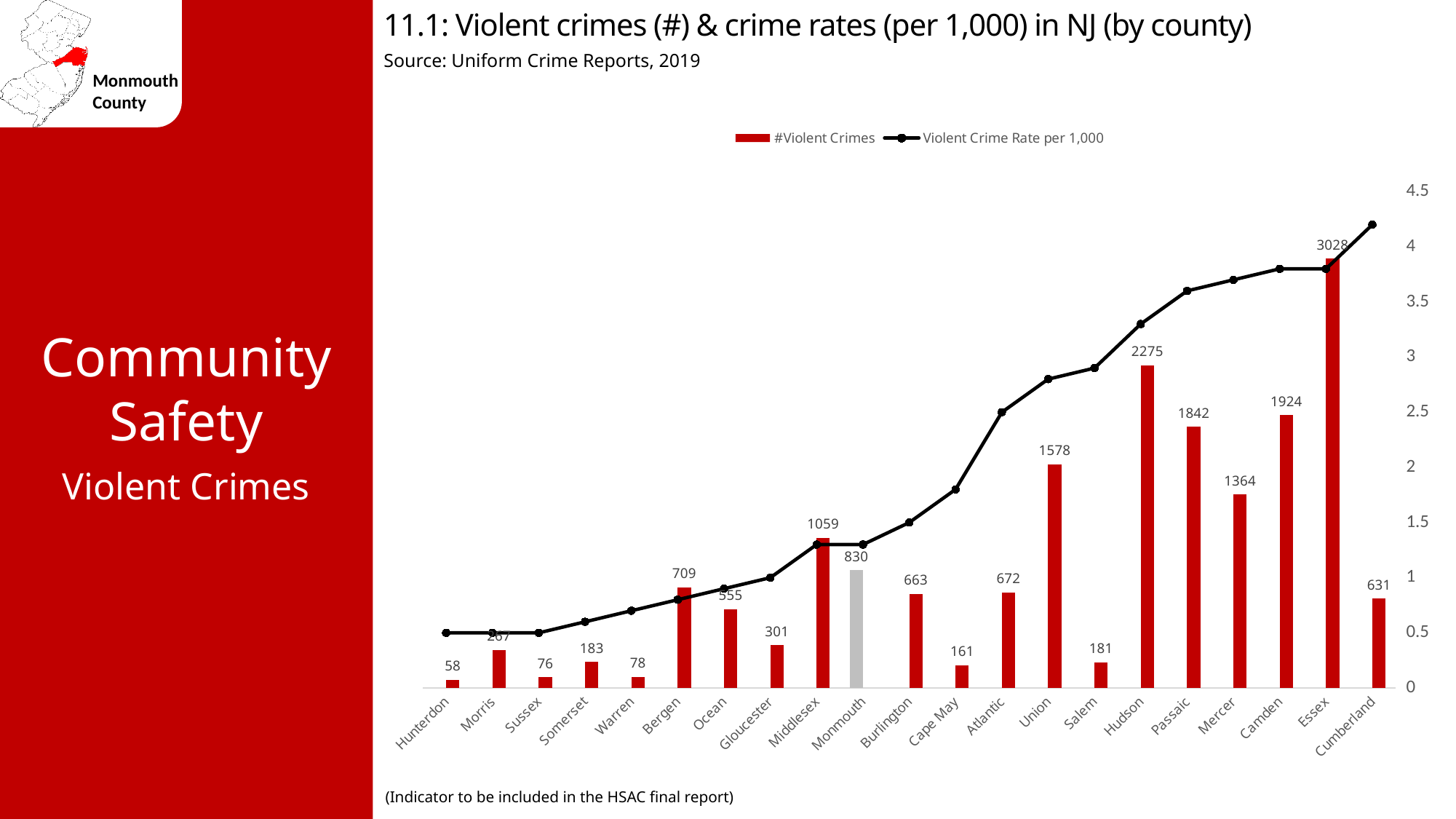
Does the violent crime rate per 1,000 line generally rise or fall from Hunterdon to Cumberland? Rise What kind of chart is this? Combined bar and line chart Which county has the lowest number of violent crimes? Hunterdon Is the violent crime rate per 1,000 for Union greater or less than 2.5? greater Which county has more violent crimes, Camden or Passaic? Camden How many counties are shown on the x axis? 21 How many violent crimes are shown for Essex County? 3028 What is the difference in the number of violent crimes between Hudson and Passaic? 433 What is the number of violent crimes for Monmouth County? 830 How many series does the legend list? 2 Which county has the highest number of violent crimes? Essex Is the violent crime rate per 1,000 for Cumberland greater or less than 4? greater